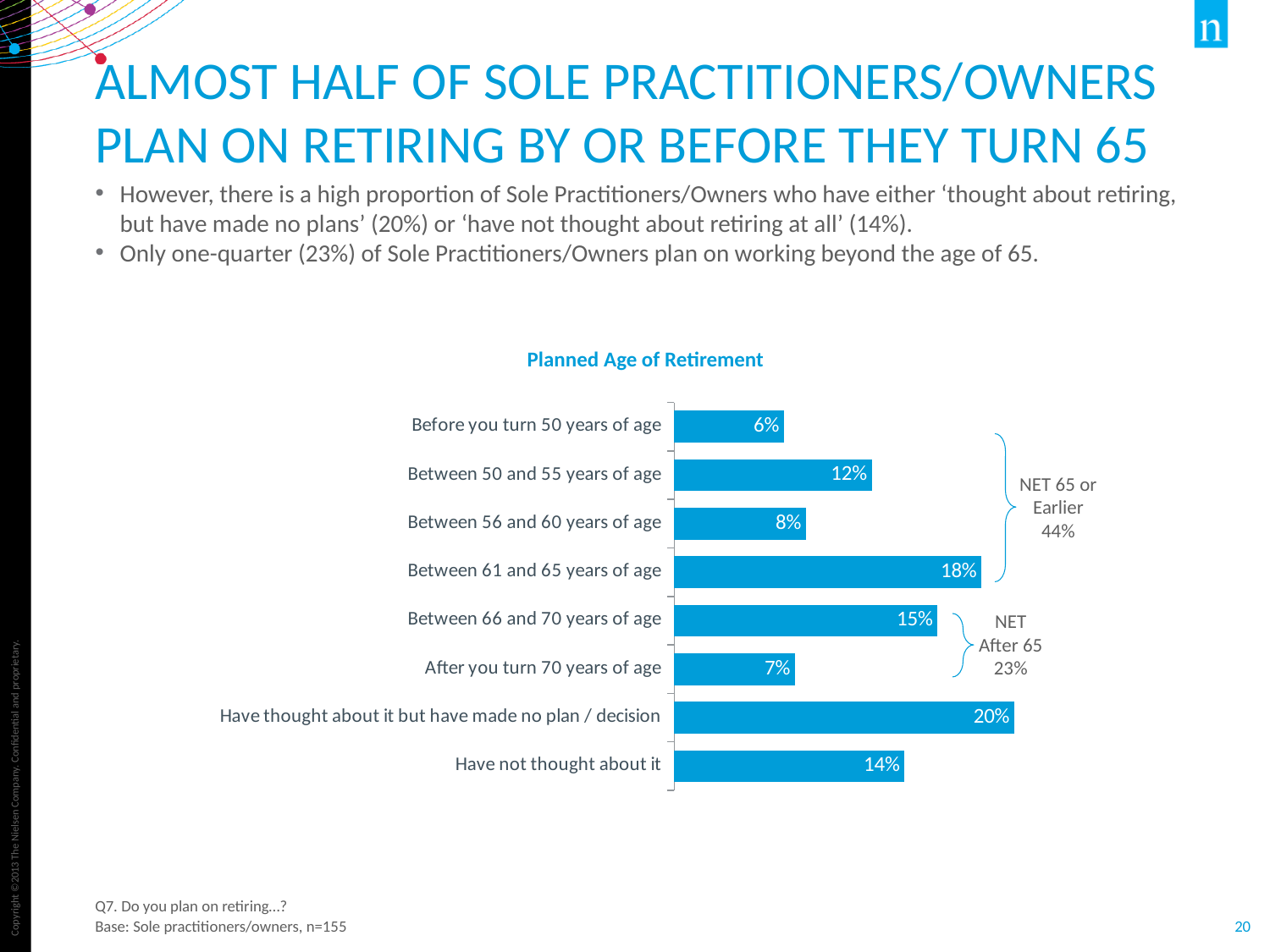
What is the value for 'Between 61 and 65 years of age' in the Planned Age of Retirement chart? 18% What is the value for 'Have not thought about it' in the Planned Age of Retirement chart? 14% What is the NET After 65 value shown on the Planned Age of Retirement chart? 23% What is the NET 65 or Earlier value shown on the Planned Age of Retirement chart? 44% Which category has the highest value in the Planned Age of Retirement chart? Have thought about it but have made no plan / decision What is the difference between 'Have thought about it but have made no plan / decision' and 'Have not thought about it' in the Planned Age of Retirement chart? 6% What kind of chart is the Planned Age of Retirement chart? Bar chart What is the difference between 'Between 66 and 70 years of age' and 'After you turn 70 years of age' in the Planned Age of Retirement chart? 8% Which is larger in the Planned Age of Retirement chart: 'Between 50 and 55 years of age' or 'Between 56 and 60 years of age'? Between 50 and 55 years of age Which category has the lowest value in the Planned Age of Retirement chart? Before you turn 50 years of age What is the value for 'Before you turn 50 years of age' in the Planned Age of Retirement chart? 6% How many categories are shown in the Planned Age of Retirement chart? 8